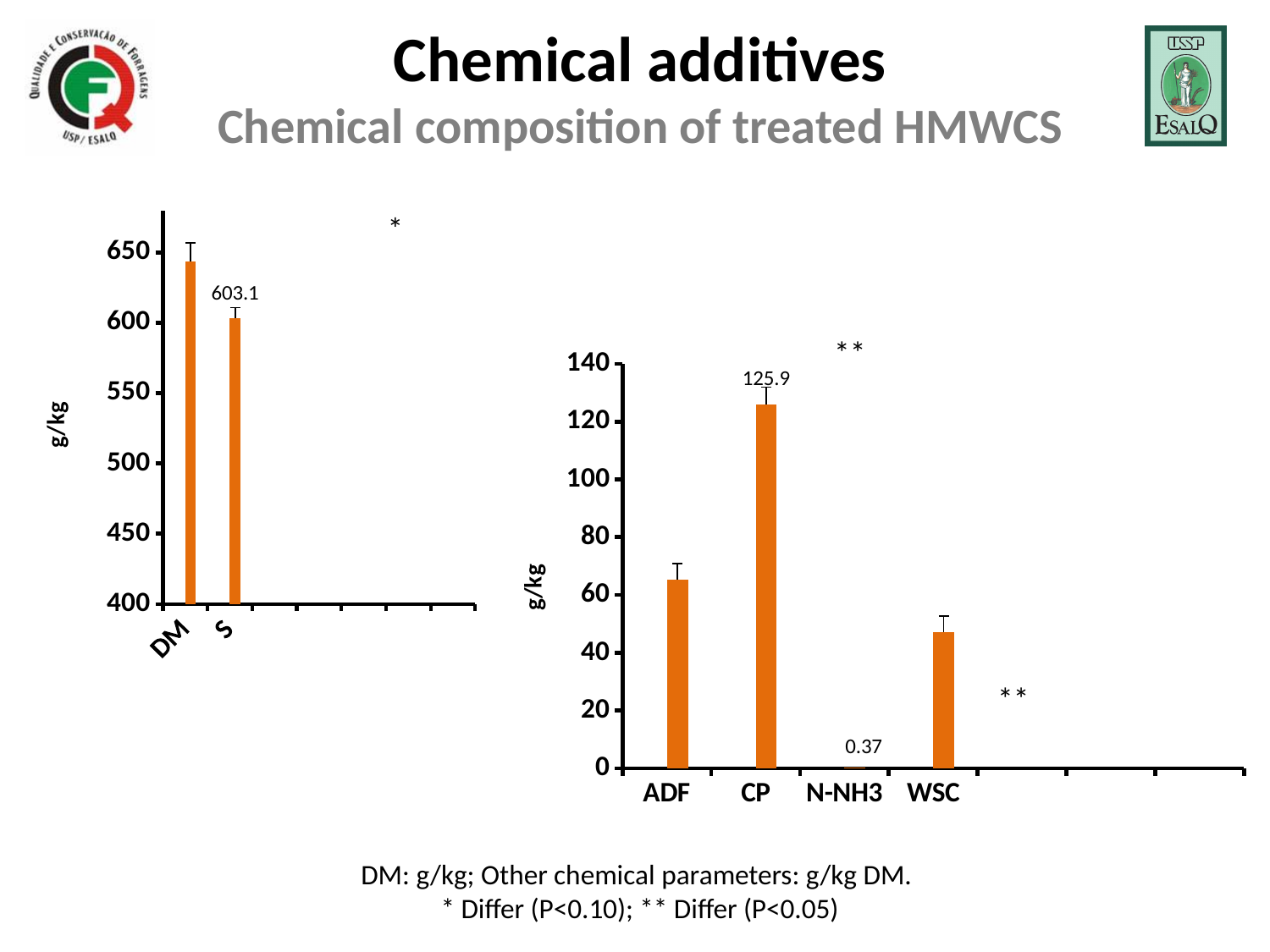
In the left chart, which of the two bars is taller, DM or S? DM In the right chart, which category has the highest value? CP In the right chart, what is the value for CP? 125.9 What is the y-axis label of the right chart? g/kg In the right chart, what is the value for N-NH3? 0.37 In the right chart, which category has the lowest value? N-NH3 In the left chart, what is the value for S? 603.1 In the left chart, is the value for DM greater or less than 600? greater What kind of chart is the left chart? bar chart In the right chart, is the value for ADF greater or less than 60? greater In the right chart, is the value for WSC greater or less than 60? less How many labelled categories are shown in the right chart? 4